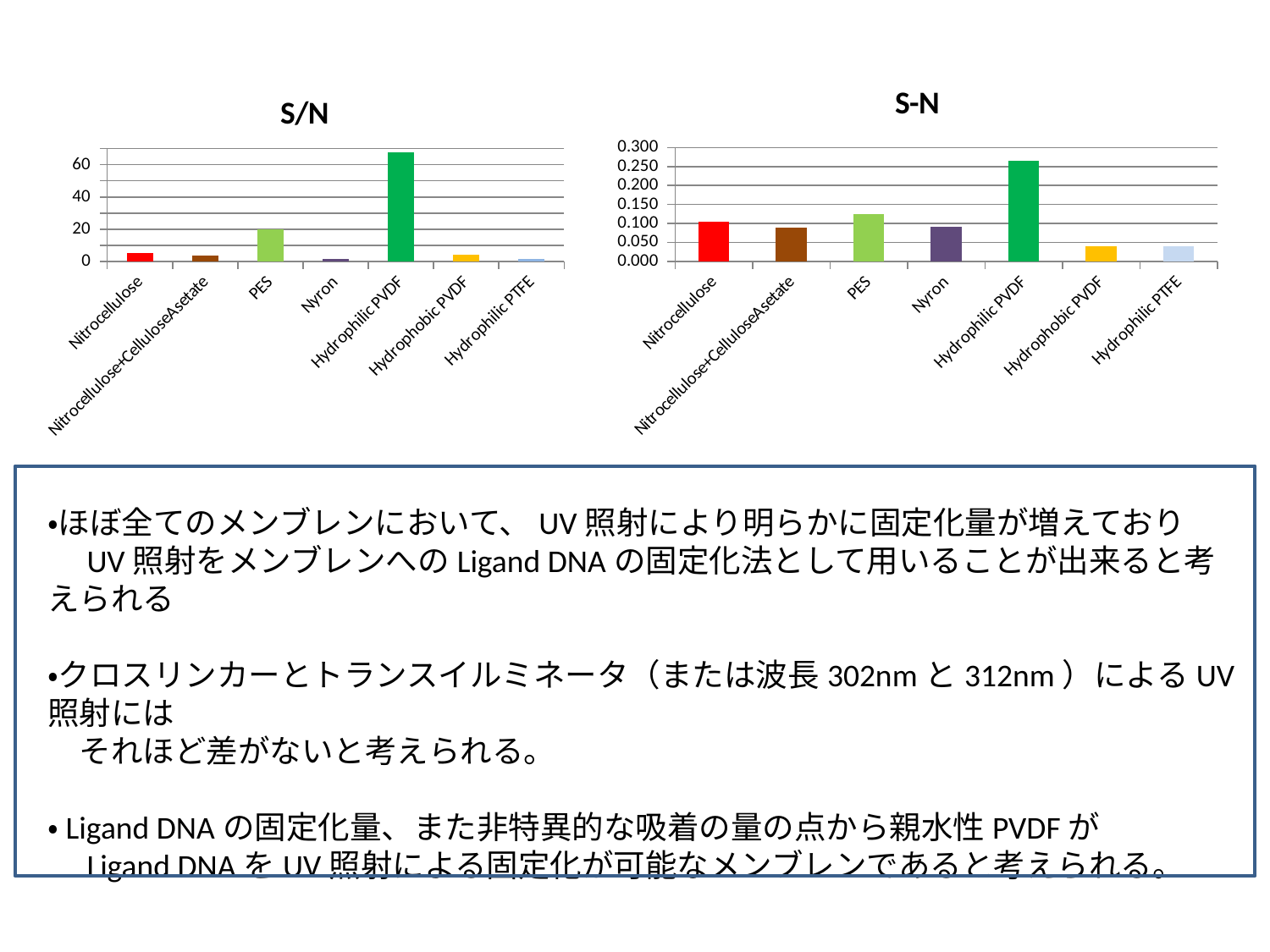
In the S-N chart, which is larger, the value for PES or the value for Nyron? PES How many categories are shown in the S-N chart? 7 What is the title of the chart on the right side of the slide? S-N In the S/N chart, which category has the highest value? Hydrophilic PVDF In the S-N chart, which category has the highest value? Hydrophilic PVDF In the S/N chart, which is larger, the value for PES or the value for Nitrocellulose? PES In the S-N chart, is the value for Hydrophobic PVDF greater or less than 0.050? less In the S/N chart, is the value for Hydrophilic PVDF greater or less than 60? greater What kind of chart is the S/N chart? bar chart How many categories are shown in the S/N chart? 7 In the S/N chart, is the value for Nitrocellulose greater or less than 20? less